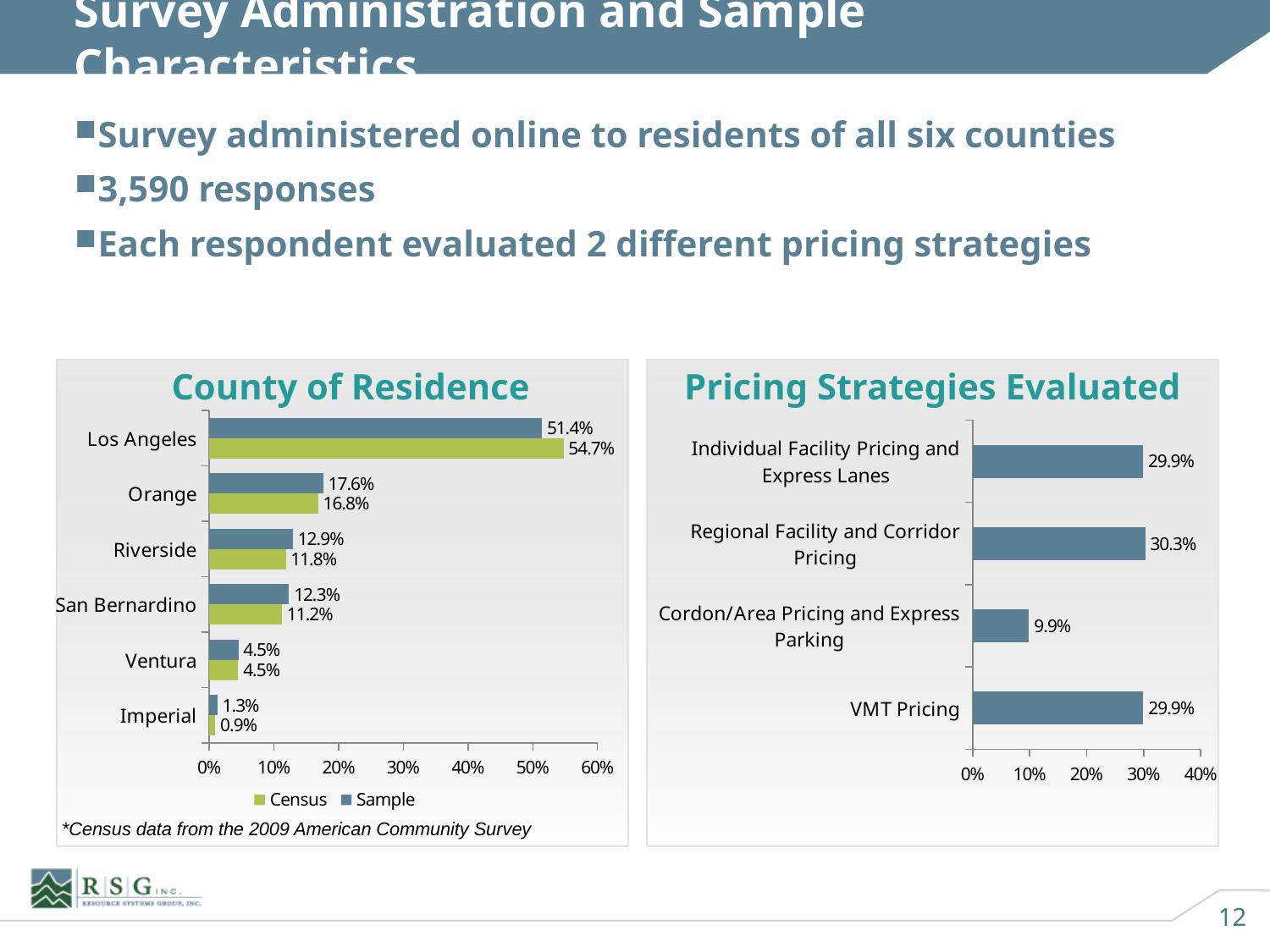
In the County of Residence chart, what is the Census value for Orange? 16.8% In the County of Residence chart, which colour represents the Census series? Green In the County of Residence chart, which county has the lowest Sample value? Imperial In the County of Residence chart, is the Sample value for Riverside larger or smaller than the Census value for Riverside? larger In the Pricing Strategies Evaluated chart, what is the difference between Regional Facility and Corridor Pricing and VMT Pricing? 0.4% In the Pricing Strategies Evaluated chart, which strategy has the highest value? Regional Facility and Corridor Pricing What kind of chart is the Pricing Strategies Evaluated chart? Bar chart In the County of Residence chart, what is the Sample value for Los Angeles? 51.4% How many series does the legend of the County of Residence chart list? 2 How many counties are shown in the County of Residence chart? 6 In the County of Residence chart, what is the difference between the Census and Sample values for Los Angeles? 3.3% In the Pricing Strategies Evaluated chart, what is the value for Cordon/Area Pricing and Express Parking? 9.9%